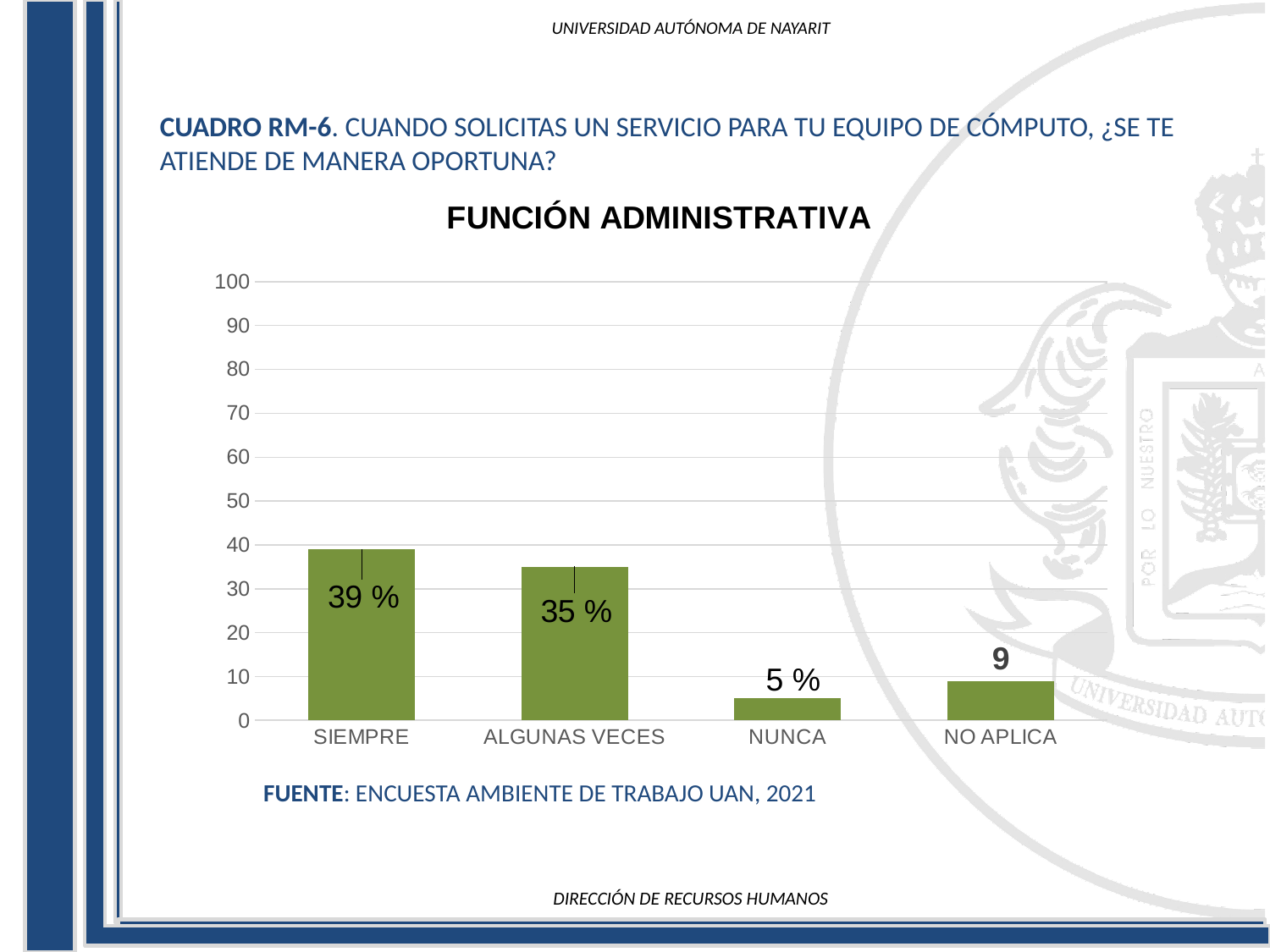
Which is larger, the value for ALGUNAS VECES or the value for NUNCA? ALGUNAS VECES Which category has the highest value? SIEMPRE What is the value for SIEMPRE? 39 % What is the value for NUNCA? 5 % What is the title of the chart? FUNCIÓN ADMINISTRATIVA How many categories are shown on the x axis? 4 What is the data label shown for NO APLICA? 9 Which category has the lowest value? NUNCA What is the value for ALGUNAS VECES? 35 % What is the difference between the values for SIEMPRE and ALGUNAS VECES? 4 % What kind of chart is shown? bar chart Is the value for SIEMPRE greater or less than 30? greater